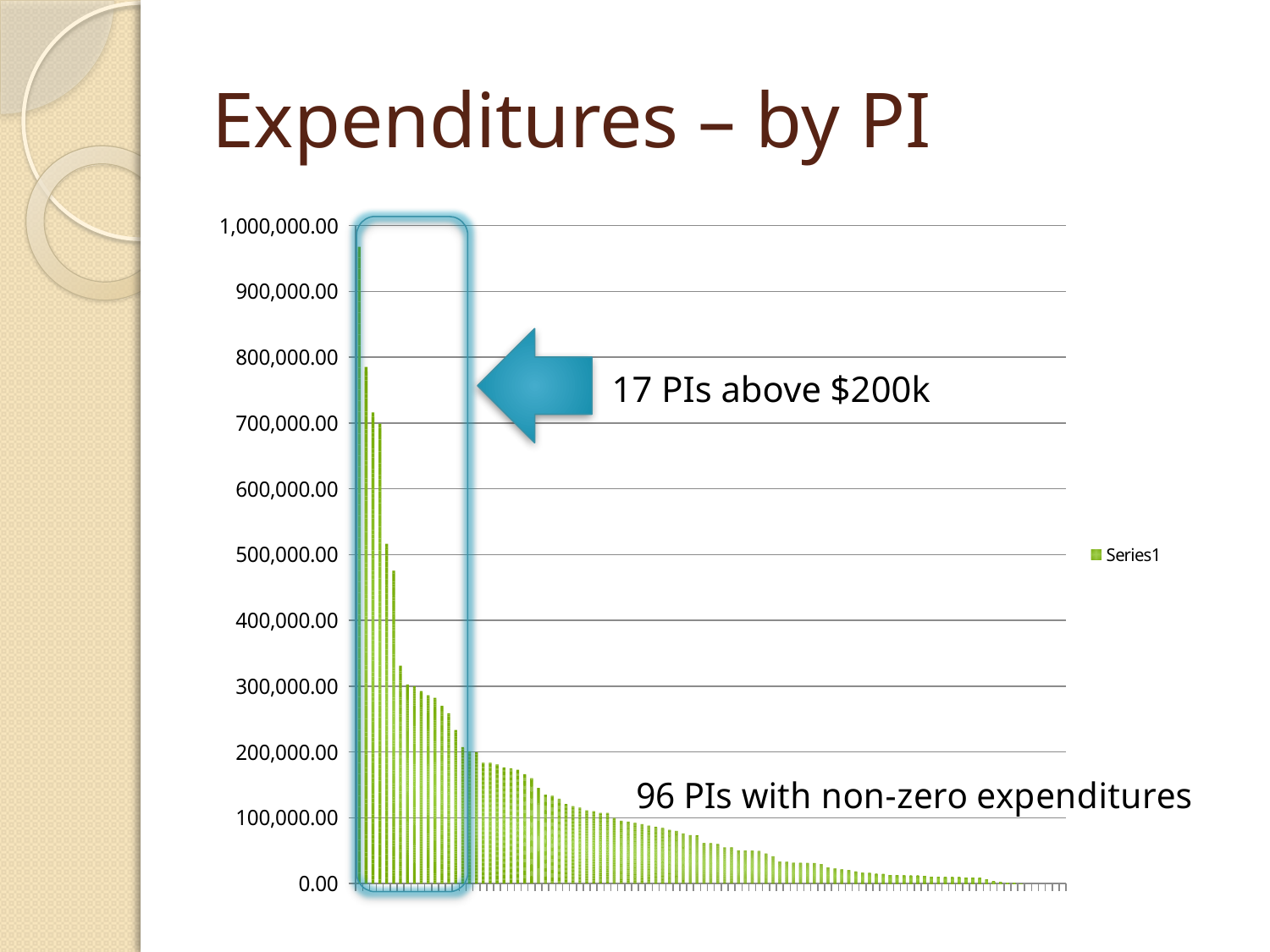
What kind of chart is shown on the slide? bar chart Is the value of the rightmost visible bar greater or less than 100,000.00? less What is the title of the slide containing the chart? Expenditures – by PI Which bar is the highest: the leftmost bar or the rightmost bar? the leftmost bar Is the value of the tallest bar greater or less than 900,000.00? greater Is the value of the second-tallest bar greater or less than 700,000.00? greater Do the bar values rise or fall moving from left to right along the x axis? fall What is the highest value shown on the vertical axis? 1,000,000.00 What is the name of the series shown in the legend? Series1 How many series does the legend list? 1